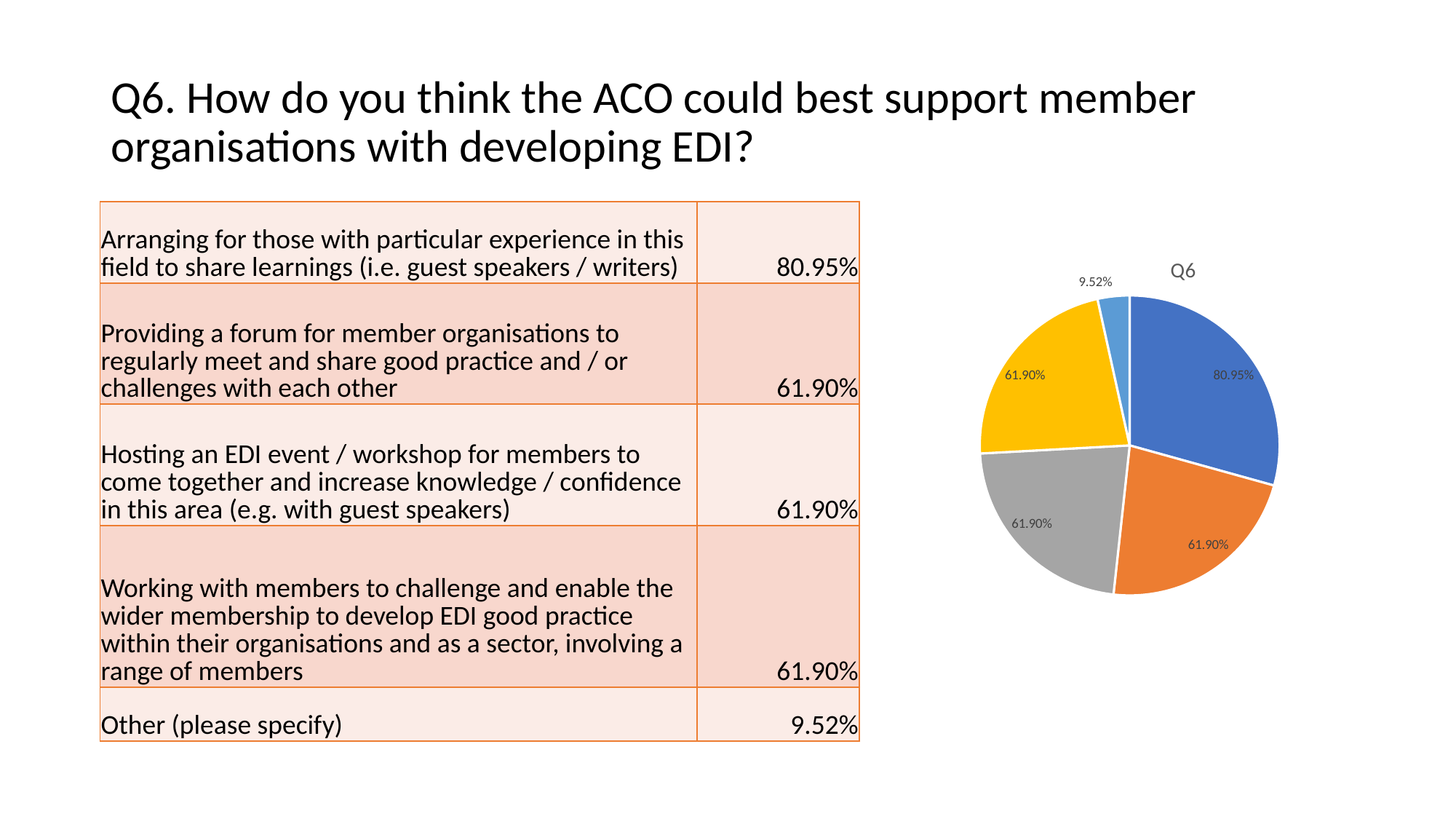
What value is labelled on the small light blue slice of the pie chart? 9.52% Which slice is larger in the pie chart, the dark blue slice or the grey slice? dark blue What kind of chart is shown on the slide? pie chart How many slices of the pie chart are labelled 61.90%? 3 What is the difference between the largest slice value (80.95%) and the smallest slice value (9.52%) in the pie chart? 71.43% What is the difference between the dark blue slice (80.95%) and the orange slice (61.90%) in the pie chart? 19.05% What is the value shown on the largest slice of the pie chart? 80.95% What is the title of the pie chart? Q6 What is the value shown on the smallest slice of the pie chart? 9.52% How many slices does the pie chart have? 5 What value is labelled on the orange slice of the pie chart? 61.90% What value is labelled on the dark blue slice of the pie chart? 80.95%